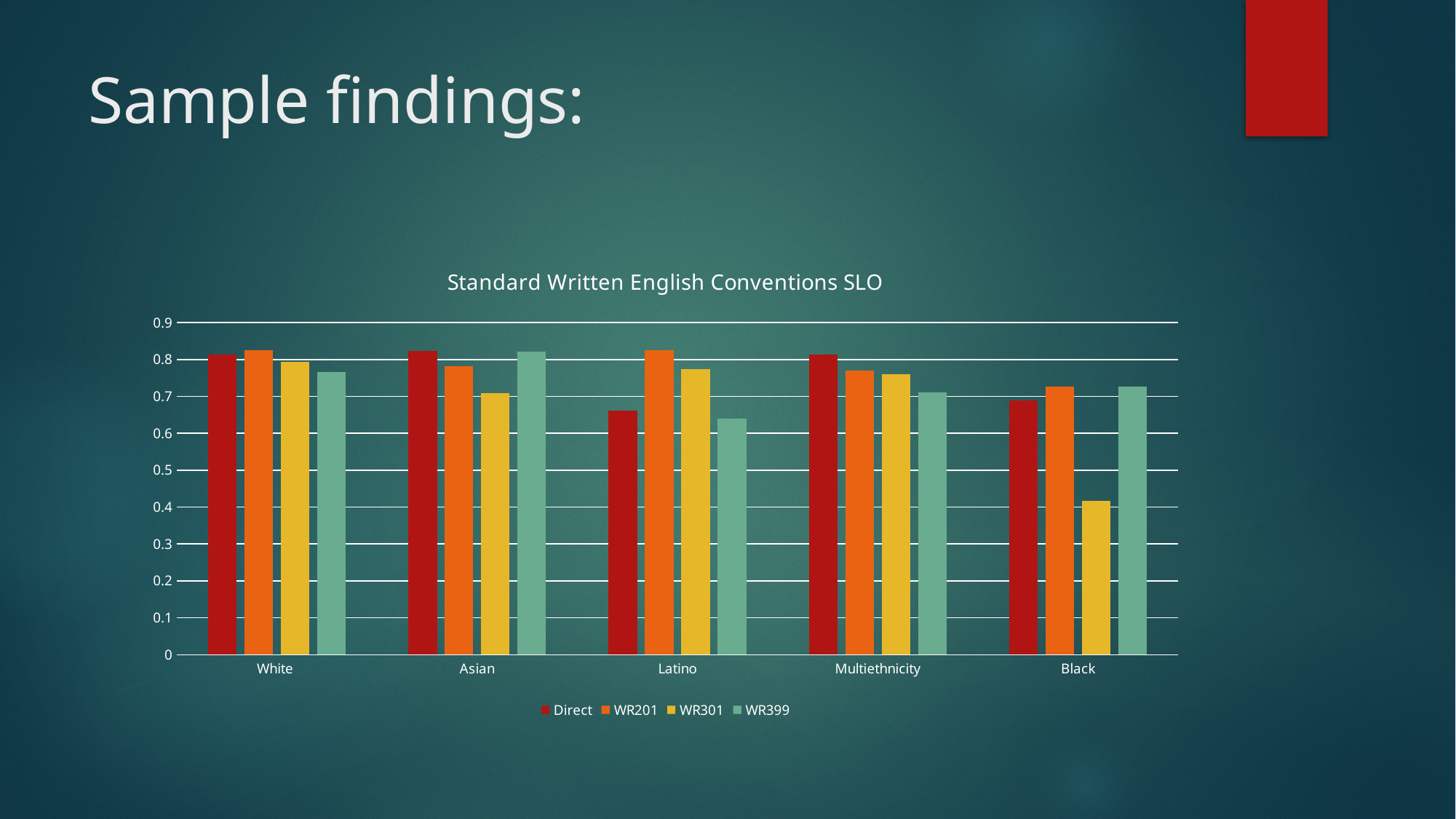
Is the value for WR301 in the Black category greater or less than 0.5? less What is the title of the chart? Standard Written English Conventions SLO What type of chart is shown on the slide? Bar chart Which series has the lowest value for Black? WR301 How many categories are shown on the x axis? 5 Which series is shown in dark red in the legend? Direct Which is larger for Asian: the WR301 value or the WR399 value? WR399 Is the value for WR201 in the Latino category greater or less than 0.8? greater How many series does the legend list? 4 Which is larger for Latino: the Direct value or the WR201 value? WR201 Is the value for Direct in the Latino category greater or less than 0.6? greater Which series has the highest value for Latino? WR201